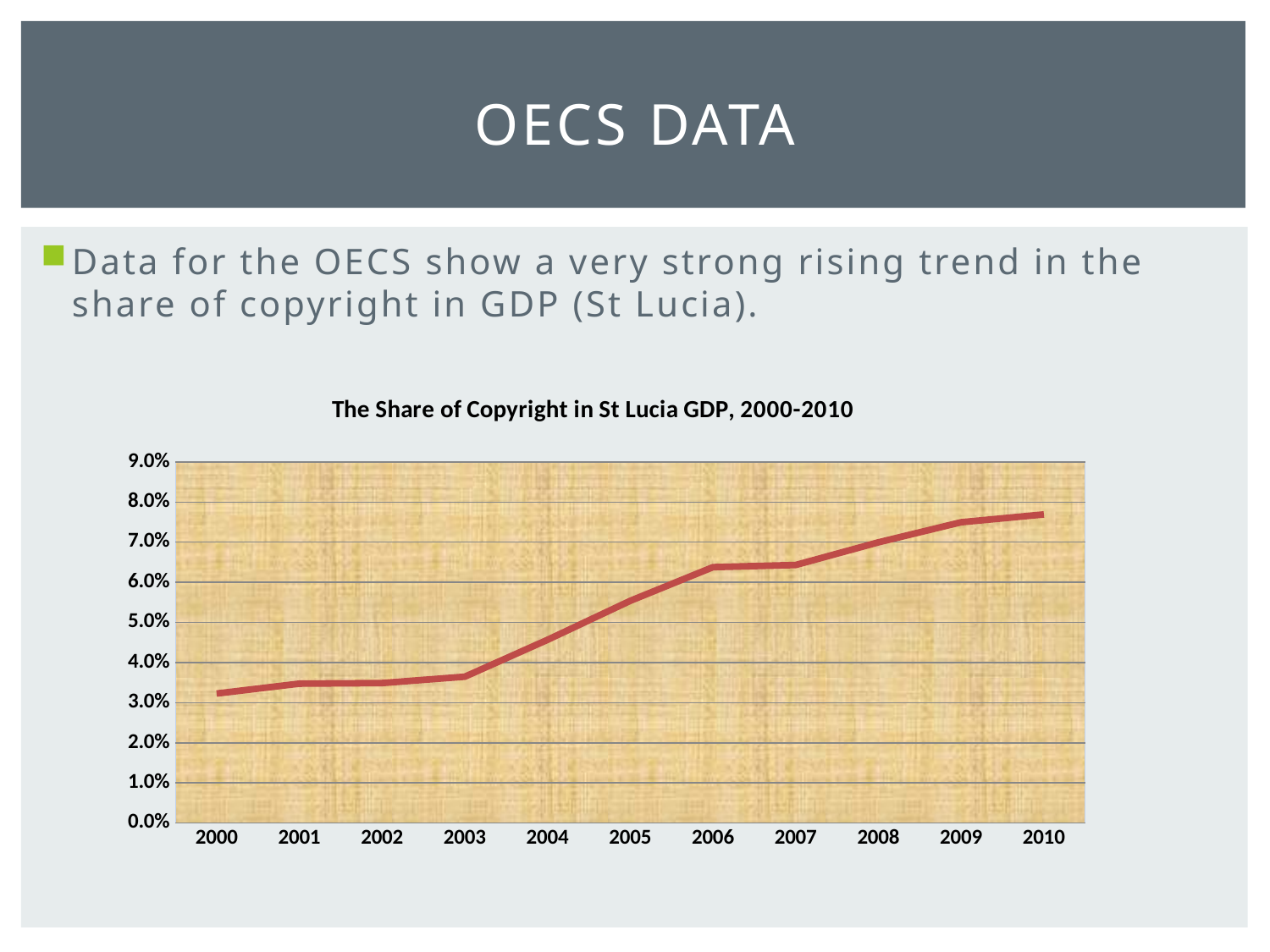
Do the values in the chart generally rise or fall from 2000 to 2010? Rise Is the value for 2010 greater or less than 7.0%? greater What is the title of the chart? The Share of Copyright in St Lucia GDP, 2000-2010 Is the value for 2006 greater or less than 6.0%? greater Is the value for 2005 greater or less than 5.0%? greater Which year has the highest share of copyright in St Lucia GDP? 2010 What kind of chart is shown on the slide? Line chart Which year has the lowest share of copyright in St Lucia GDP? 2000 How many years are plotted on the x axis of the chart? 11 Which is larger, the value for 2004 or the value for 2008? 2008